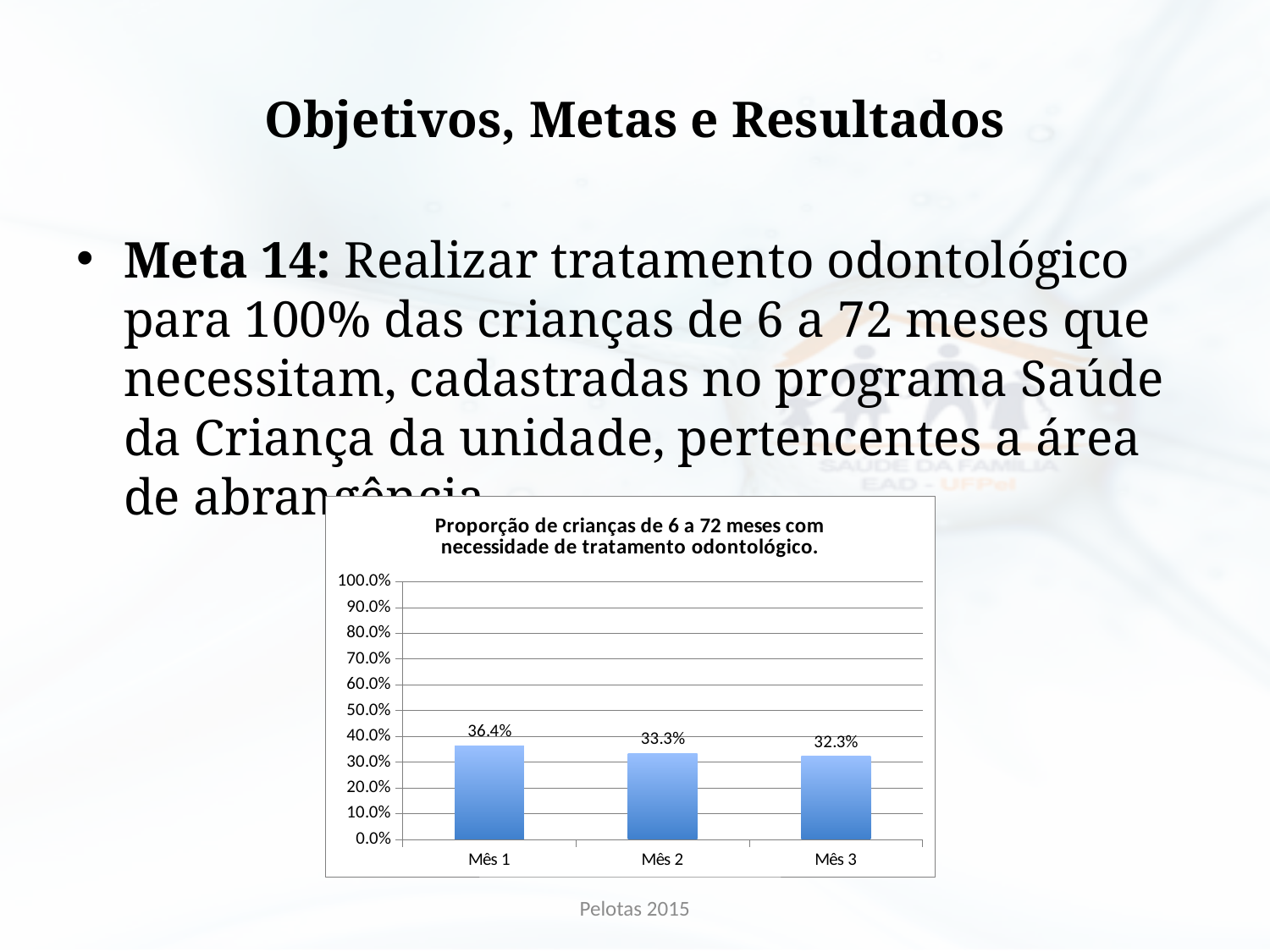
Do the values rise or fall from Mês 1 to Mês 3? fall How many months are shown on the x axis? 3 What is the difference between the values for Mês 1 and Mês 2? 3.1% What is the value for Mês 2? 33.3% What is the value for Mês 1? 36.4% Which month has the highest value? Mês 1 What kind of chart is shown on the slide? bar chart What is the value for Mês 3? 32.3% Which month has the lowest value? Mês 3 What is the difference between the values for Mês 1 and Mês 3? 4.1% Which is larger, the value for Mês 1 or the value for Mês 2? Mês 1 Is the value for Mês 2 greater or less than 50.0%? less